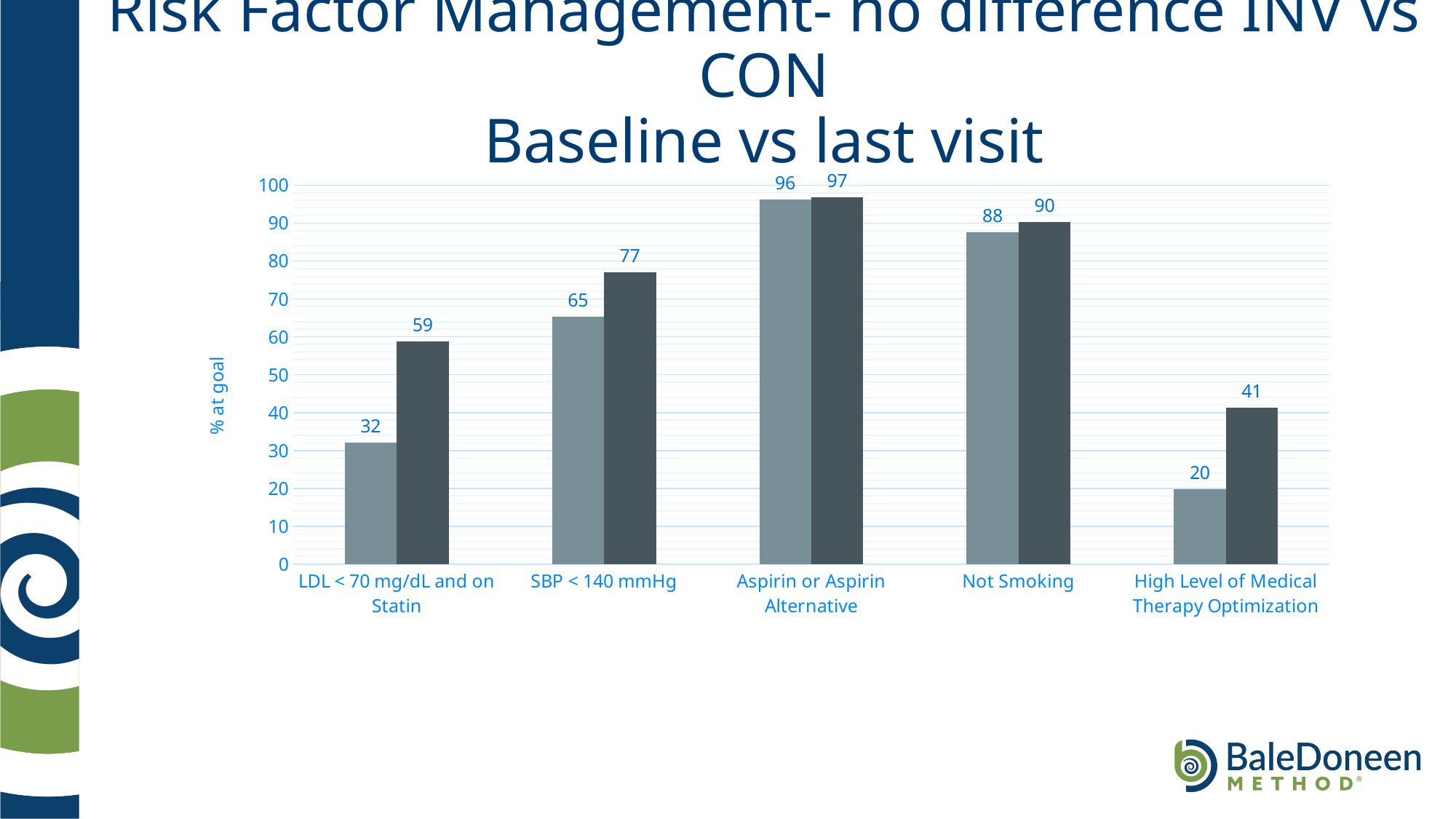
What is the value of the lighter (first) bar for 'LDL < 70 mg/dL and on Statin'? 32 Which is larger: the lighter bar for 'Not Smoking' or the lighter bar for 'SBP < 140 mmHg'? Not Smoking What is the difference between the darker and lighter bars for 'High Level of Medical Therapy Optimization'? 21 What is the label of the y axis of the chart? % at goal What is the value of the darker (second) bar for 'High Level of Medical Therapy Optimization'? 41 What is the value of the darker (second) bar for 'SBP < 140 mmHg'? 77 Which category has the highest value for the darker (second) bar? Aspirin or Aspirin Alternative Is the value of the lighter (first) bar for 'Not Smoking' greater or less than 80? greater What type of chart is shown on the slide? bar chart What is the difference between the darker and lighter bars for 'LDL < 70 mg/dL and on Statin'? 27 How many categories are shown on the x axis of the chart? 5 Which category has the lowest value for the lighter (first) bar? High Level of Medical Therapy Optimization